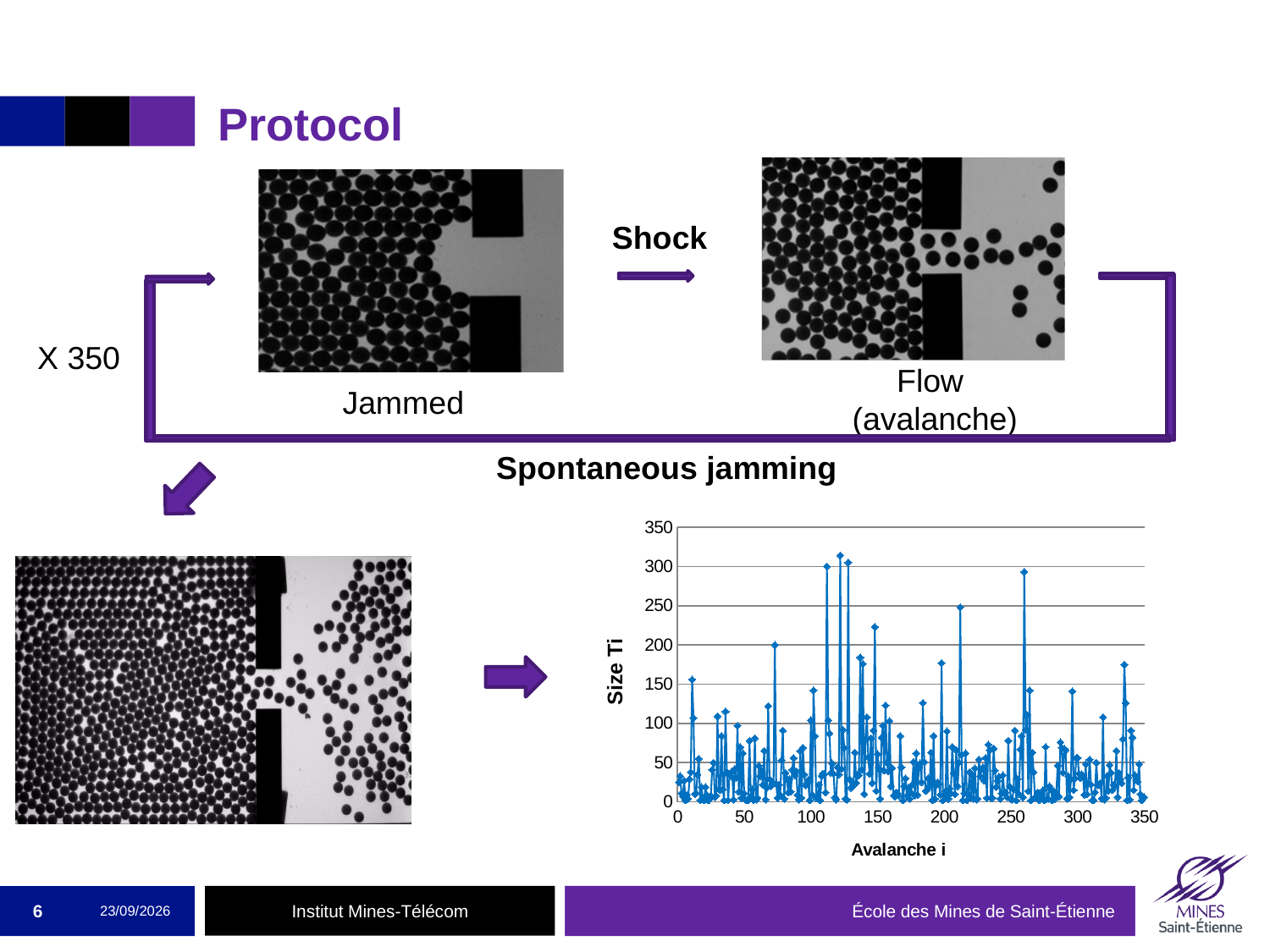
Is the highest spike plotted on the chart greater or less than 350? less What is the label of the x axis of the chart? Avalanche i What is the label of the y axis of the chart? Size Ti What kind of chart is shown on the slide? line chart Is the spike near avalanche 210 greater or less than 200? greater Is the highest spike plotted on the chart greater or less than 300? greater Which is larger: the spike near avalanche 120 or the spike near avalanche 340? the spike near avalanche 120